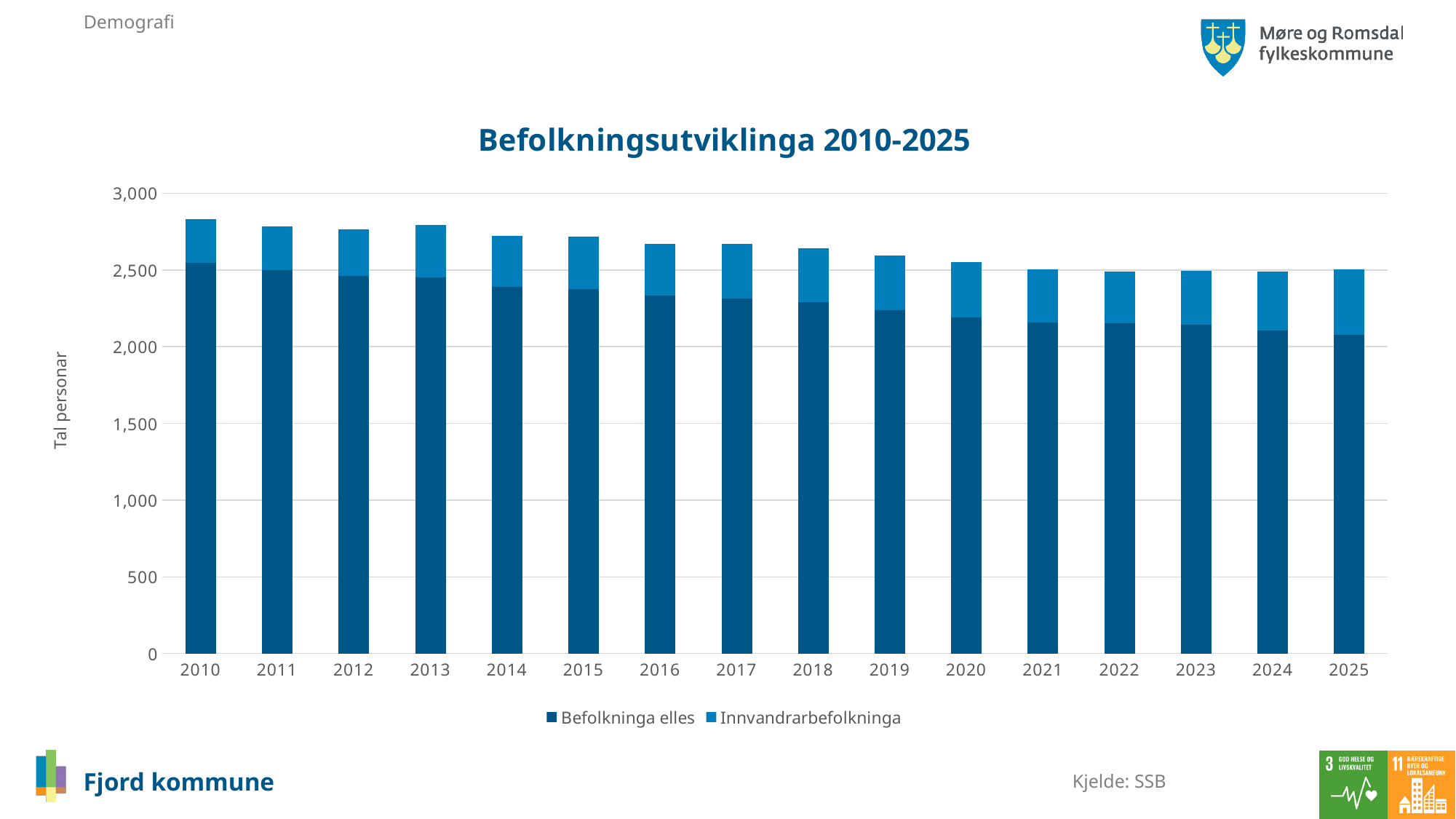
Is the total bar for 2018 greater or less than 2,500? greater Is the Befolkninga elles value for 2025 greater or less than 2,500? less Which is larger, the Befolkninga elles value for 2013 or for 2019? 2013 Which year has the largest Innvandrarbefolkninga segment? 2025 Does the Innvandrarbefolkninga series rise or fall from 2010 to 2025? rise Is the Befolkninga elles value for 2021 greater or less than 2,500? less How many years are shown on the x axis? 16 What kind of chart is shown on the slide? Stacked bar chart Does the Befolkninga elles series rise or fall from 2010 to 2025? fall Which year has the highest total population bar? 2010 How many series does the legend list? 2